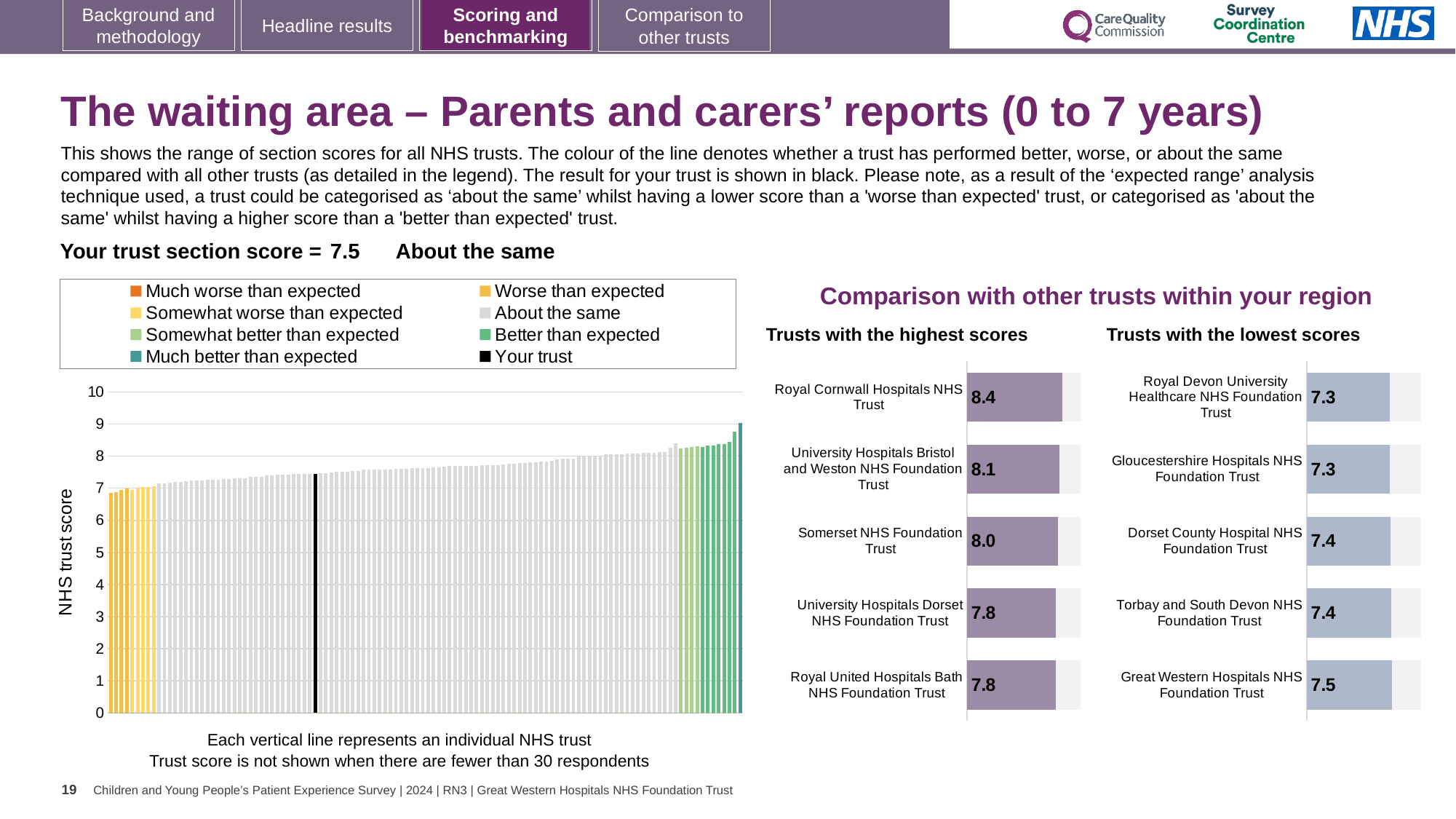
In the large chart on the left, is the value of the tallest bar greater or less than 10? less How many entries does the legend above the large chart on the left list? 8 In the 'Trusts with the lowest scores' chart, which has the larger score: Dorset County Hospital NHS Foundation Trust or Gloucestershire Hospitals NHS Foundation Trust? Dorset County Hospital NHS Foundation Trust In the 'Trusts with the highest scores' chart, what is the difference between the scores of Royal Cornwall Hospitals NHS Trust and Somerset NHS Foundation Trust? 0.4 In the 'Trusts with the highest scores' chart, how many trusts are shown? 5 In the 'Trusts with the highest scores' chart, which trust has the highest score? Royal Cornwall Hospitals NHS Trust In the 'Trusts with the lowest scores' chart, what is the score for Great Western Hospitals NHS Foundation Trust? 7.5 What kind of chart is the large chart on the left showing NHS trust scores? bar chart In the large chart on the left, what is the label on the vertical axis? NHS trust score In the 'Trusts with the lowest scores' chart, which trust has the highest score? Great Western Hospitals NHS Foundation Trust In the 'Trusts with the highest scores' chart, what is the score for Royal Cornwall Hospitals NHS Trust? 8.4 In the large chart on the left, is the value of the black bar (your trust) greater or less than 7? greater